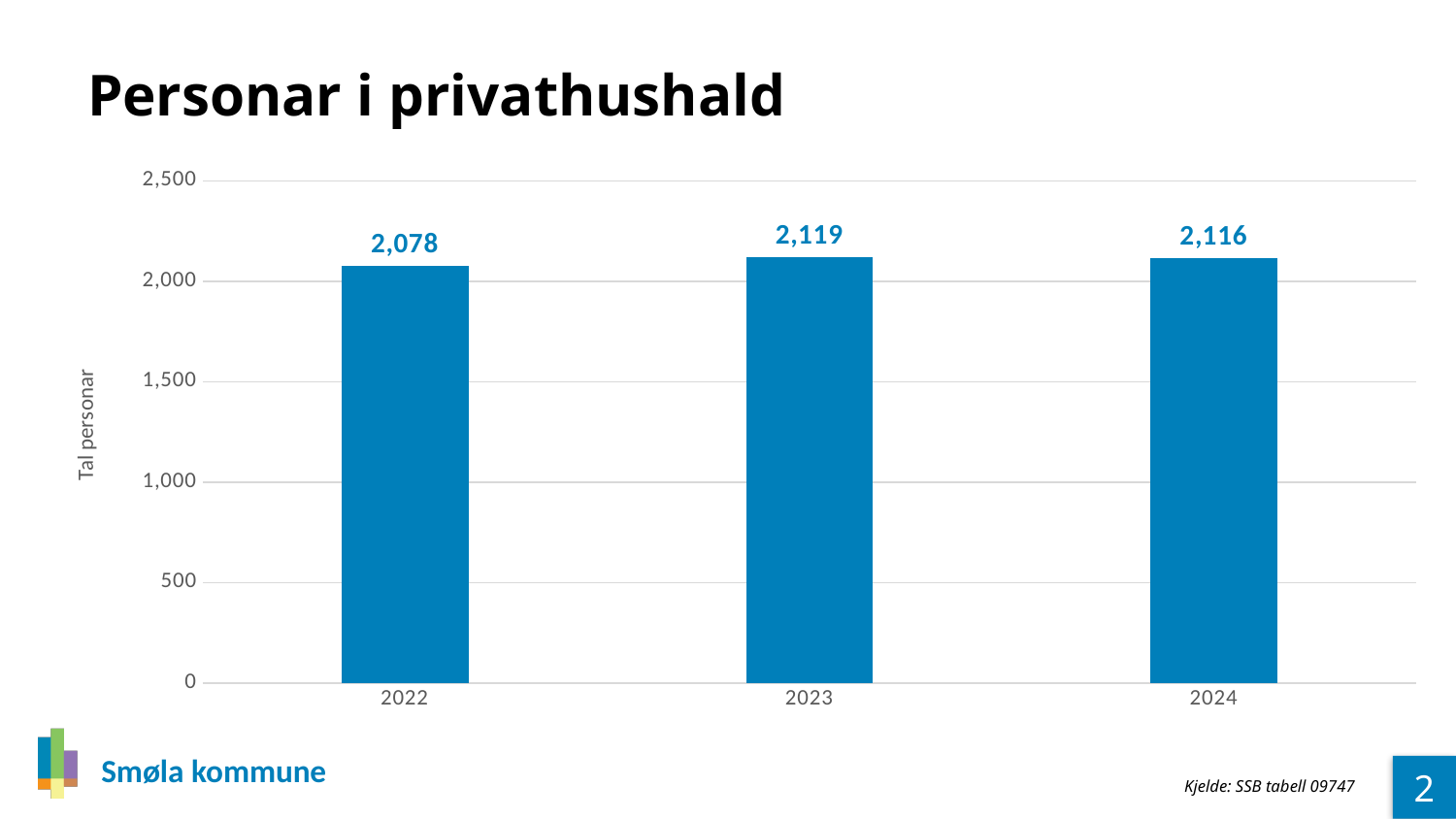
What is the difference between the values for 2023 and 2024? 3 What is the value for 2023? 2,119 Which is larger, the value for 2022 or the value for 2024? 2024 What is the title of the chart? Personar i privathushald Which year has the highest value? 2023 Is the value for 2022 greater or less than 2,000? greater What is the value for 2022? 2,078 What is the difference between the values for 2023 and 2022? 41 Which year has the lowest value? 2022 What kind of chart is shown on the slide? bar chart What is the value for 2024? 2,116 How many years are shown on the x axis? 3